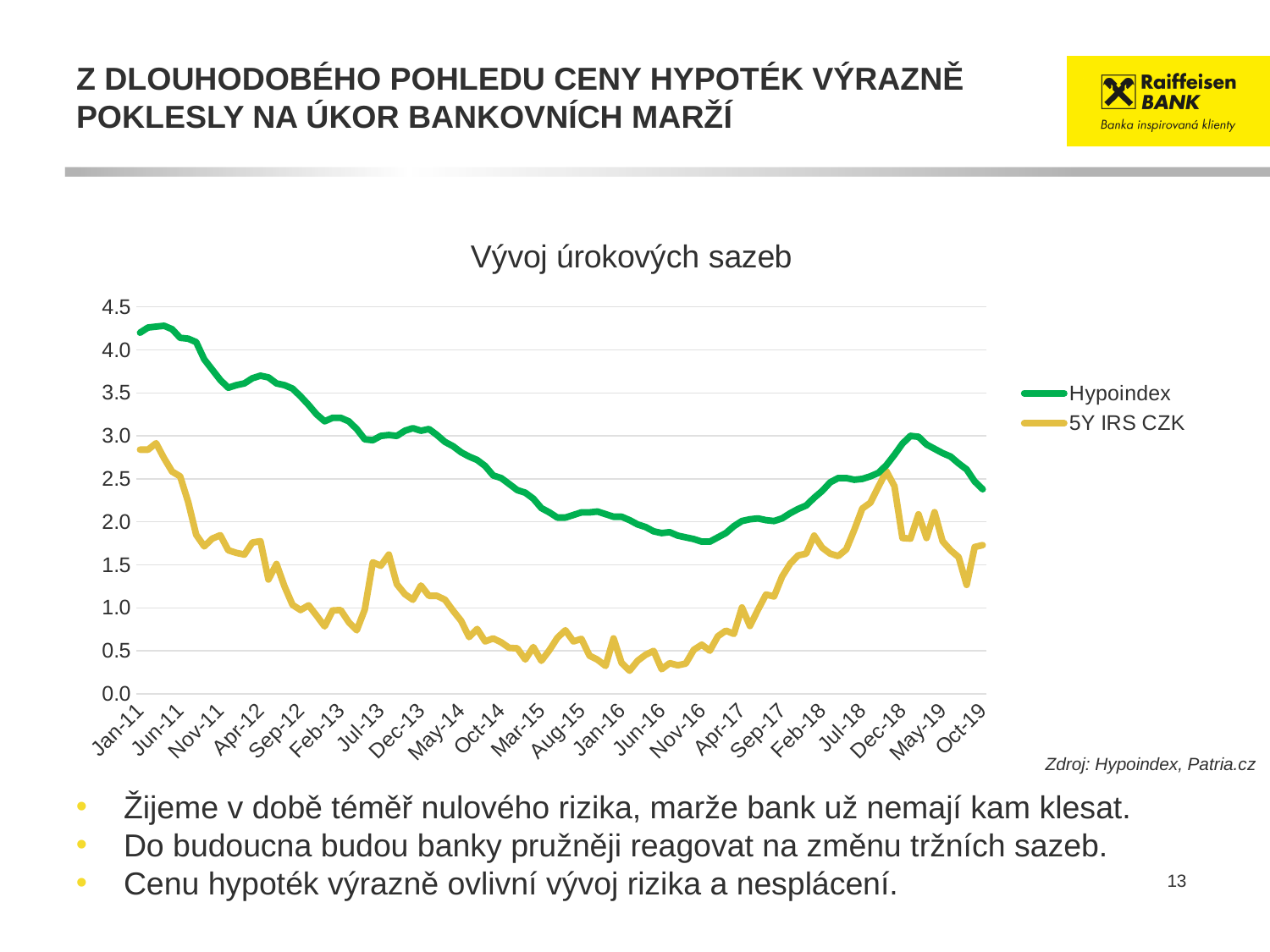
What is the title of the chart? Vývoj úrokových sazeb Is the value of Hypoindex at Nov-16 greater or less than 2.0? less Is the value of 5Y IRS CZK at Jan-11 greater or less than 2.5? greater Which series is drawn in green in the chart? Hypoindex How many series does the legend of the chart list? 2 Is the value of Hypoindex at Jan-11 greater or less than 4.0? greater What kind of chart is shown on the slide? line chart Does the Hypoindex series rise or fall between Jan-11 and Nov-16? fall At Jan-11, which series has the higher value, Hypoindex or 5Y IRS CZK? Hypoindex